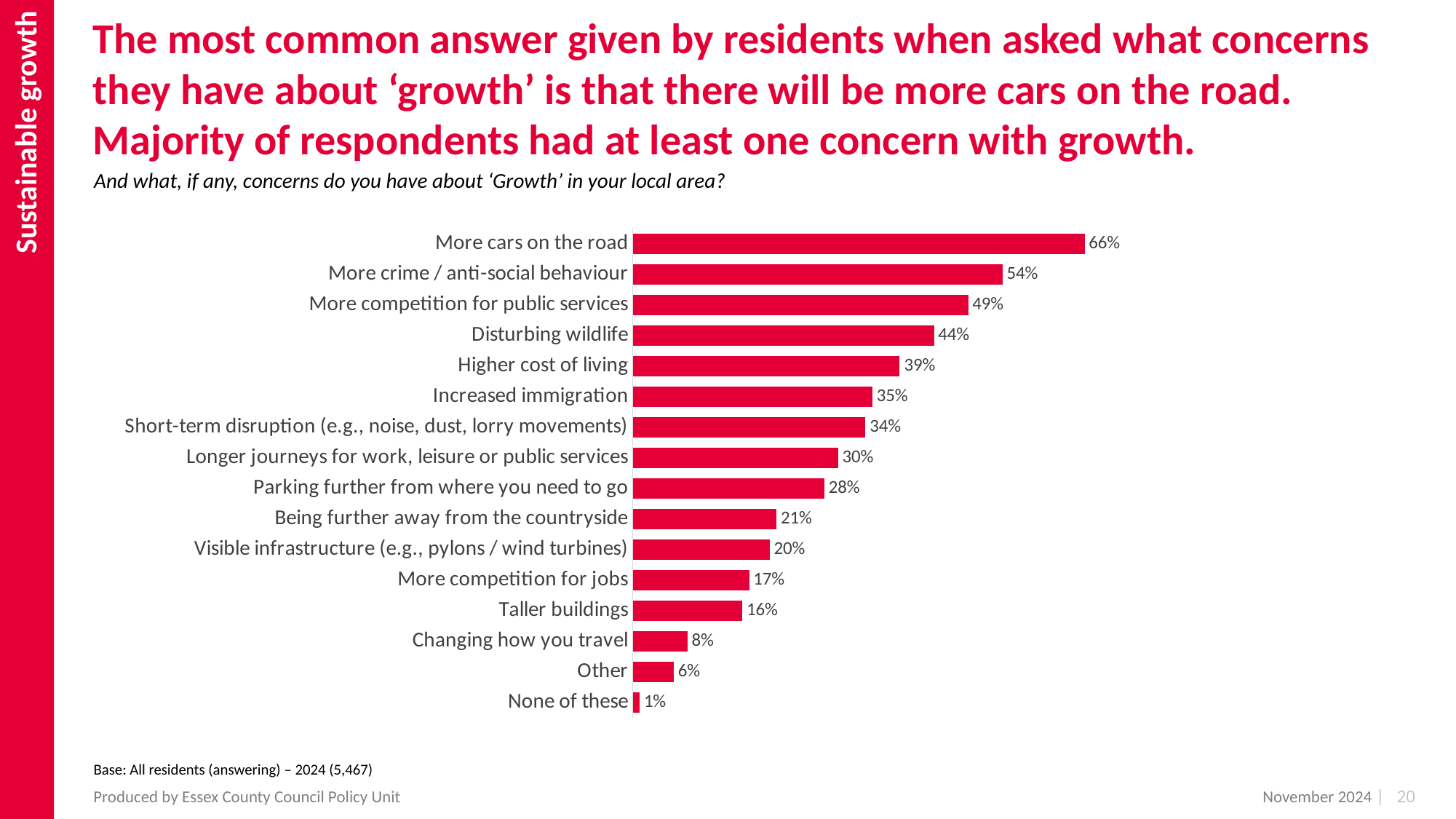
What is the base size stated below the chart? 5,467 What is the value shown for 'Disturbing wildlife'? 44% What type of chart is shown on the slide? Bar chart What percentage of residents said 'More cars on the road' was a concern about growth? 66% What is the difference between 'Higher cost of living' and 'Increased immigration'? 4% Which is larger: 'Parking further from where you need to go' or 'Being further away from the countryside'? Parking further from where you need to go Which concern has the highest percentage in the chart? More cars on the road What percentage of respondents selected 'Taller buildings'? 16% Which category has the lowest value in the chart? None of these How many categories are shown in the chart? 16 Which has the higher value: 'Changing how you travel' or 'Other'? Changing how you travel What is the difference between the values for 'More cars on the road' and 'More crime / anti-social behaviour'? 12%